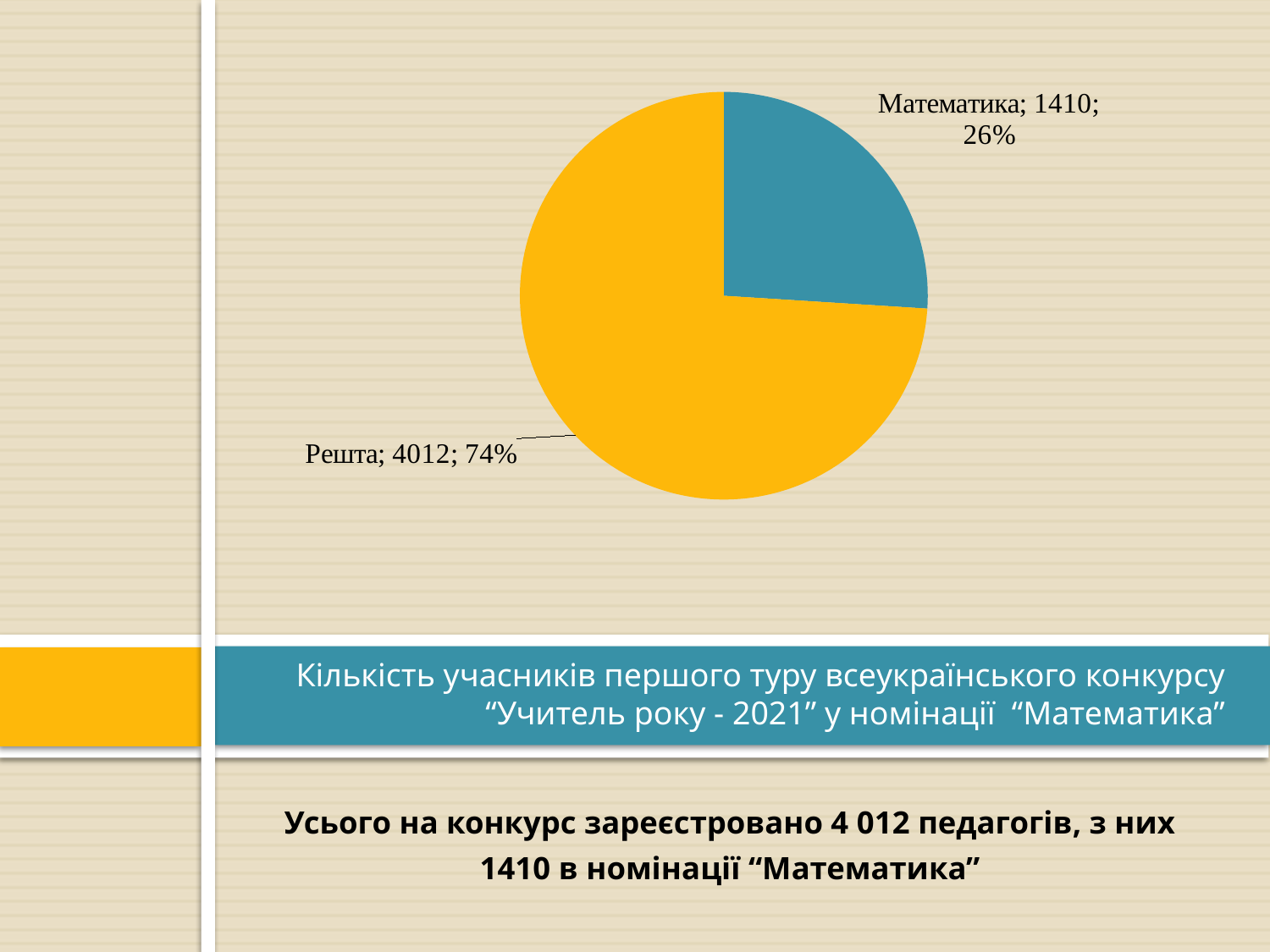
What colour is the "Решта" slice? Yellow What value is shown for the "Математика" slice? 1410 Which slice of the pie chart is the largest? Решта What percentage share does the "Математика" slice have? 26% Which slice of the pie chart is the smallest? Математика What kind of chart is shown on the slide? Pie chart What percentage share does the "Решта" slice have? 74% What value is shown for the "Решта" slice? 4012 What is the difference between the value for "Решта" and the value for "Математика"? 2602 How many slices does the pie chart have? 2 Which is larger, the value for "Математика" or the value for "Решта"? Решта What colour is the "Математика" slice? Blue